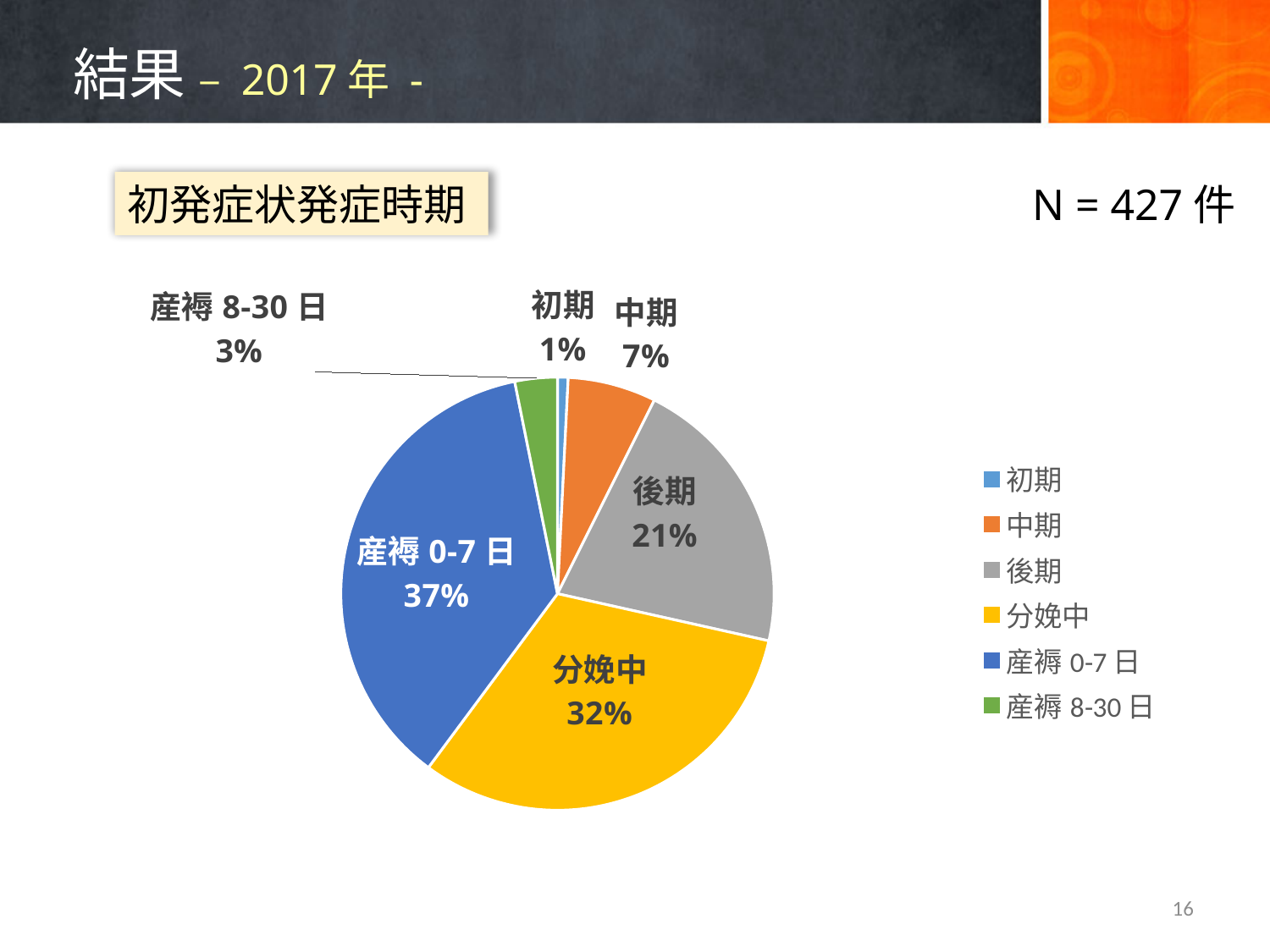
What is the total number of cases (N) stated on the slide? 427 件 What share of the pie does 初期 represent? 1% Which category has the largest slice of the pie? 産褥 0-7 日 What kind of chart is shown on the slide? pie chart What share of the pie does 中期 represent? 7% What share of the pie does 産褥 0-7 日 represent? 37% What is the difference in percentage points between 産褥 0-7 日 and 分娩中? 5% How many categories does the pie chart have? 6 Which is larger, the share for 後期 or the share for 中期? 後期 Which category has the smallest slice of the pie? 初期